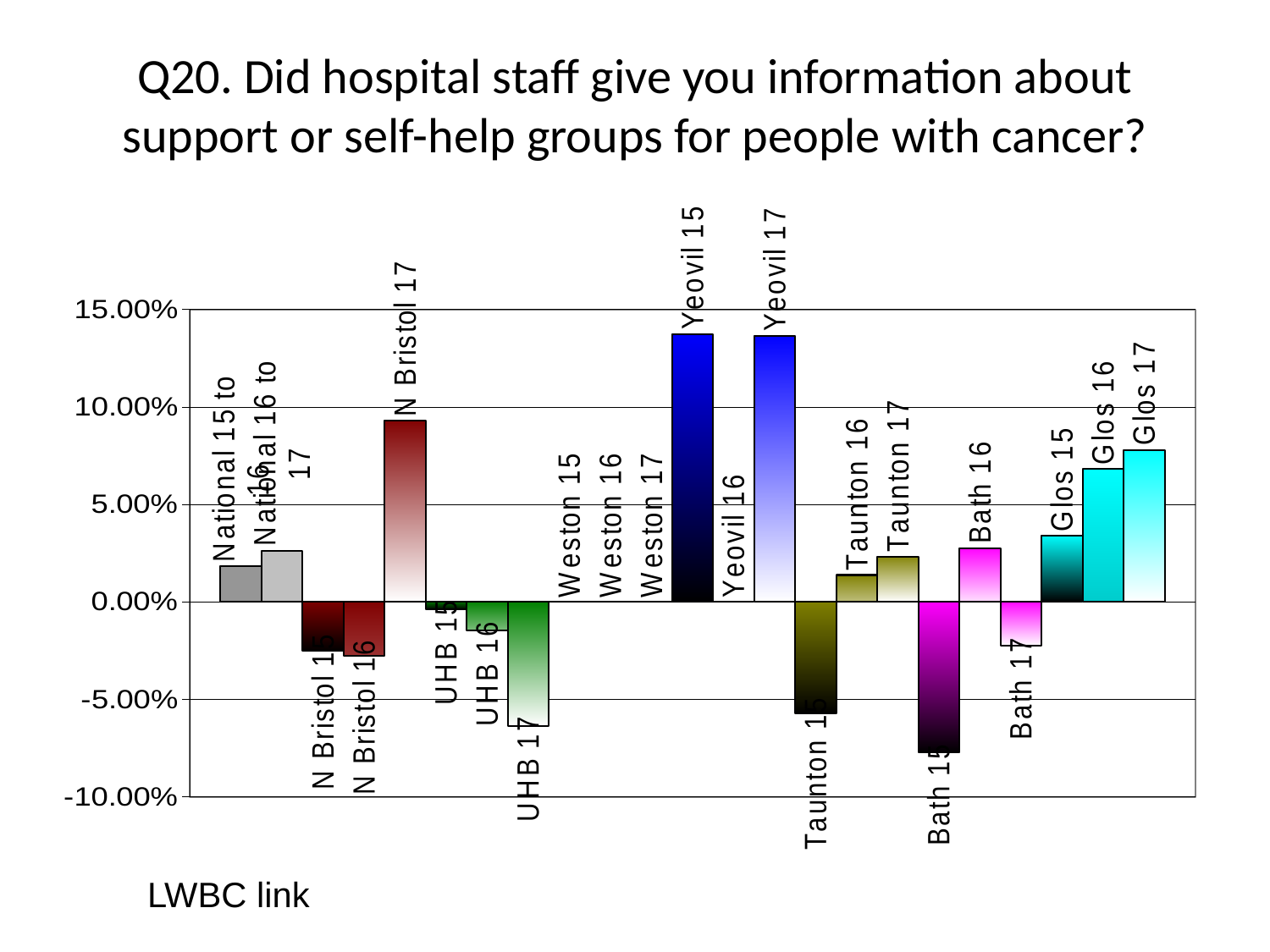
Is the value for Glos 17 greater or less than 5.00%? greater Is the value for N Bristol 17 greater or less than 5.00%? greater Do the values for Glos rise or fall from Glos 15 to Glos 17? Rise Which category has the lowest value in the chart? Bath 15 Is the value for UHB 17 greater or less than -5.00%? less Which is larger, the value for Bath 16 or the value for Bath 17? Bath 16 Which is larger, the value for Glos 15 or the value for Glos 17? Glos 17 How many categories are shown on the x axis of the chart? 23 What kind of chart is shown on the slide? Bar chart